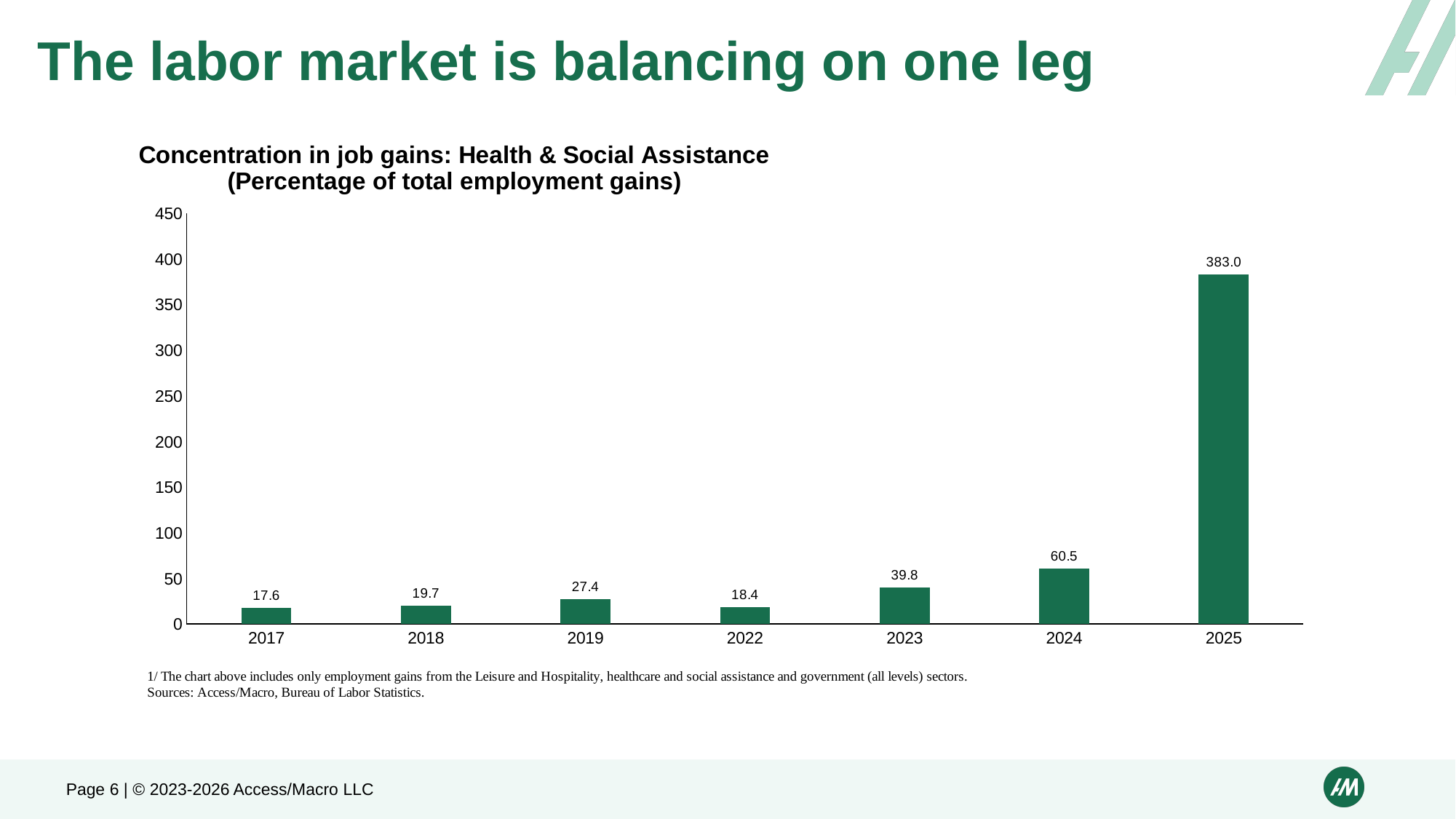
What is the difference between the values for 2024 and 2023? 20.7 What kind of chart is shown? Bar chart Which is larger, the value for 2018 or the value for 2022? 2018 How many years are shown on the x axis? 7 What is the value for 2019? 27.4 Is the value for 2025 greater or less than 350? greater Which year has the highest value? 2025 What is the title of the chart? Concentration in job gains: Health & Social Assistance (Percentage of total employment gains) What is the value for 2025? 383.0 Which year has the lowest value? 2017 Do the values rise or fall from 2022 to 2025? Rise What is the value for 2022? 18.4